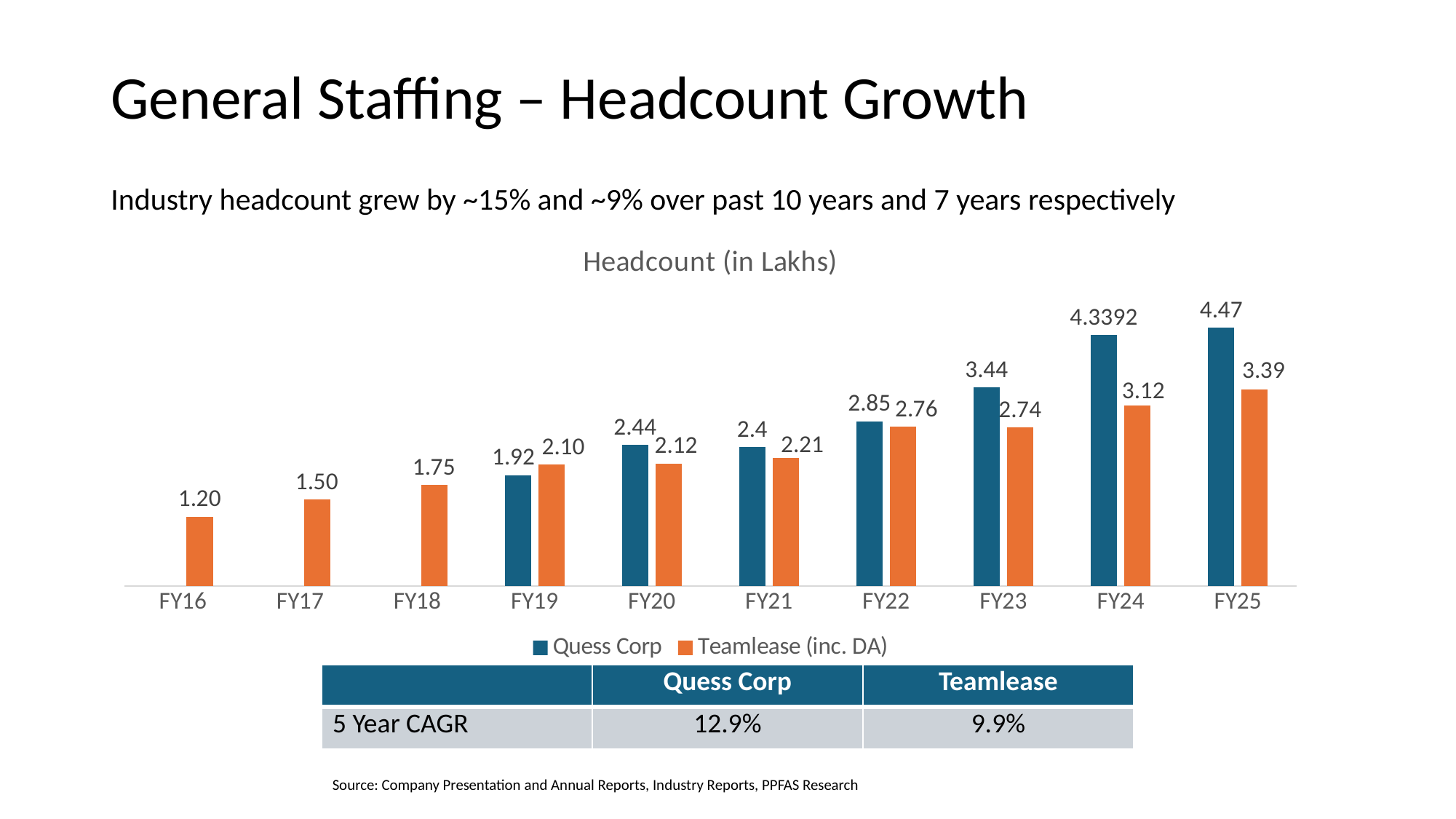
Does the Teamlease (inc. DA) headcount rise or fall from FY16 to FY25? Rise How many series does the chart legend list? 2 What is the Teamlease (inc. DA) headcount (in Lakhs) for FY22? 2.76 Which fiscal year has the highest Teamlease (inc. DA) headcount? FY25 What is the Quess Corp headcount (in Lakhs) for FY25? 4.47 In FY21, which series has the larger headcount, Quess Corp or Teamlease (inc. DA)? Quess Corp What kind of chart is shown on the slide? Bar chart What is the difference between the Quess Corp and Teamlease (inc. DA) headcounts in FY25? 1.08 What is the Teamlease (inc. DA) headcount (in Lakhs) for FY16? 1.20 Which fiscal year has the lowest Quess Corp headcount? FY19 How many fiscal years are shown on the x axis of the chart? 10 What is the Quess Corp headcount (in Lakhs) for FY24? 4.3392